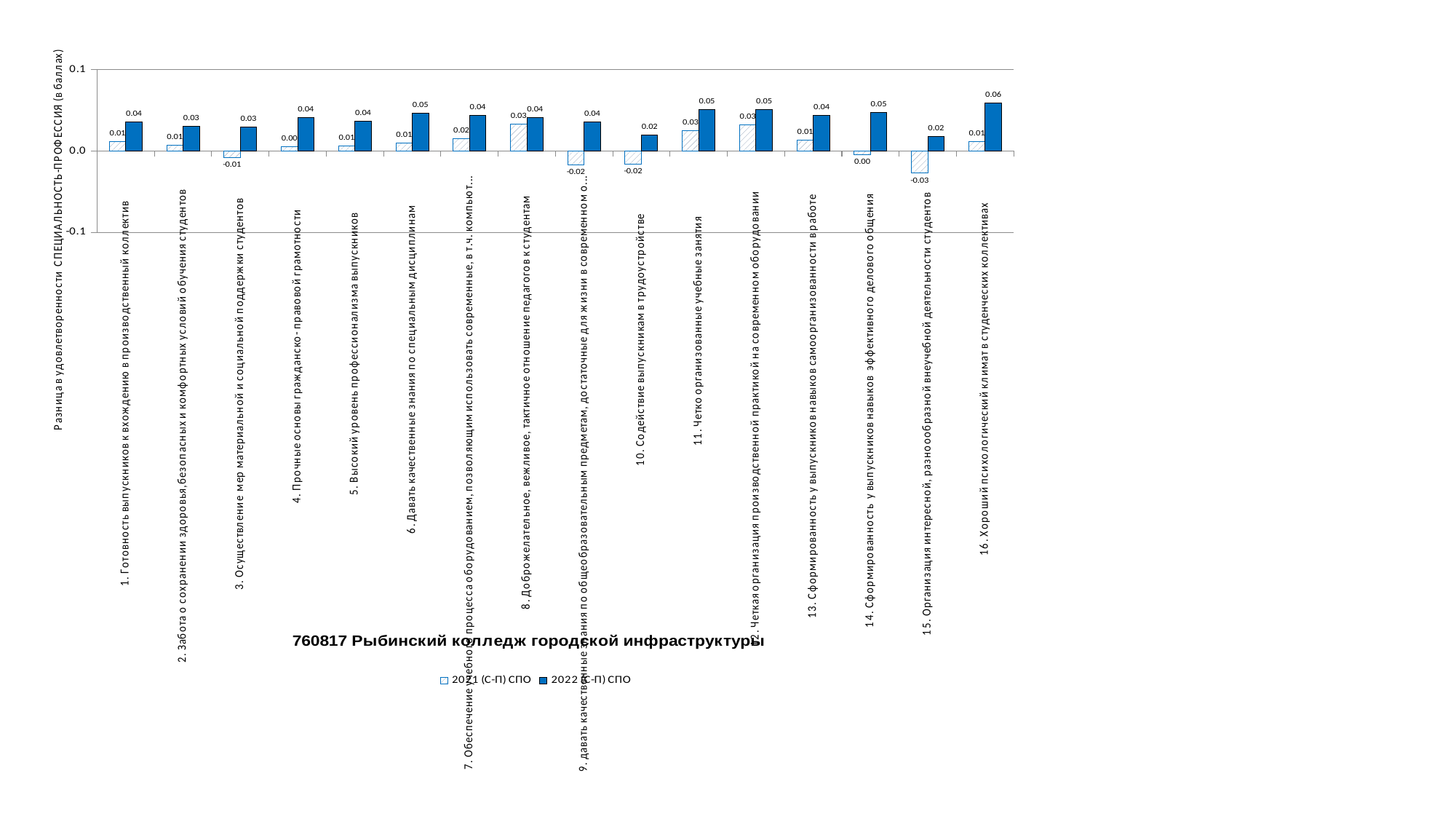
Which category has the lowest value for the 2021 (С-П) СПО series? 15. Организация интересной, разнообразной внеучебной деятельности студентов What is the difference between the 2022 (С-П) СПО and 2021 (С-П) СПО values for category 9, давать качественные знания по общеобразовательным предметам? 0.06 What is the value for 2021 (С-П) СПО for category 15, Организация интересной, разнообразной внеучебной деятельности студентов? -0.03 Which category has the highest value for the 2022 (С-П) СПО series? 16. Хороший психологический климат в студенческих коллективах How many series does the legend list? 2 What is the value for 2022 (С-П) СПО for category 16, Хороший психологический климат в студенческих коллективах? 0.06 How many categories are plotted on the x axis? 16 What is the difference between the 2022 (С-П) СПО and 2021 (С-П) СПО values for category 6, Давать качественные знания по специальным дисциплинам? 0.04 What type of chart is shown on the slide? bar chart What is the value for 2021 (С-П) СПО for category 10, Содействие выпускникам в трудоустройстве? -0.02 For category 8, Доброжелательное, вежливое, тактичное отношение педагогов к студентам, which series has the larger value: 2021 (С-П) СПО or 2022 (С-П) СПО? 2022 (С-П) СПО What is the title of the chart? 760817 Рыбинский колледж городской инфраструктуры